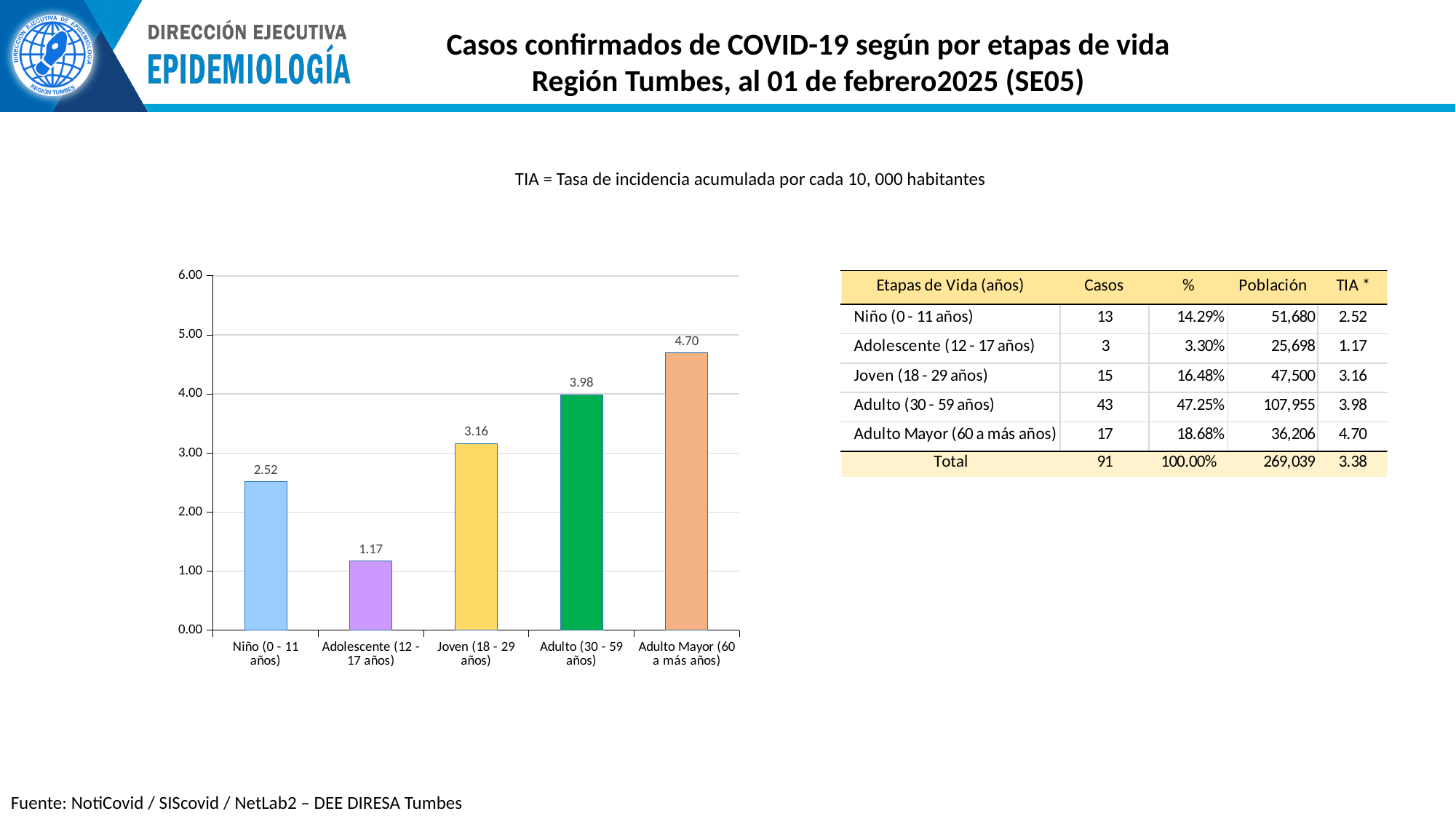
What is the difference between the values for Adulto (30 - 59 años) and Joven (18 - 29 años) in the bar chart? 0.82 Which is larger in the bar chart: the value for Niño (0 - 11 años) or the value for Joven (18 - 29 años)? Joven (18 - 29 años) Which category has the lowest bar in the chart? Adolescente (12 - 17 años) How many categories are shown on the x axis of the bar chart? 5 What is the value shown for Adulto (30 - 59 años) in the bar chart? 3.98 What is the maximum value shown on the y axis of the bar chart? 6.00 What is the value shown for Joven (18 - 29 años) in the bar chart? 3.16 What kind of chart is shown on the slide? Bar chart What is the difference between the values for Adulto Mayor (60 a más años) and Adolescente (12 - 17 años) in the bar chart? 3.53 Which category has the highest bar in the chart? Adulto Mayor (60 a más años) What is the value shown for Niño (0 - 11 años) in the bar chart? 2.52 Is the value for Adulto Mayor (60 a más años) greater or less than 4.00? greater